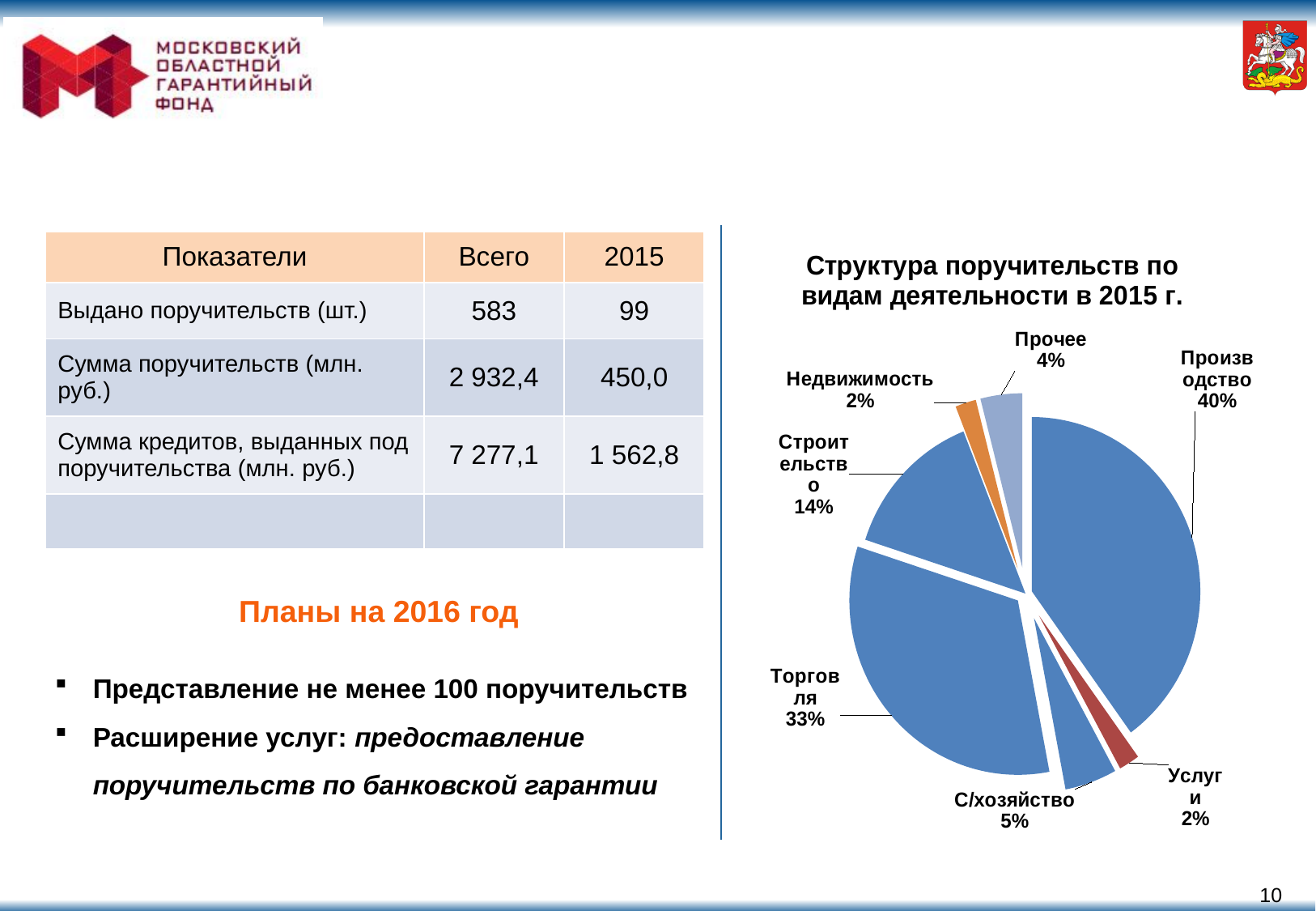
How many slices does the pie chart have? 7 What is the combined share of Производство and Торговля? 73% What share of the pie does С/хозяйство have? 5% What share of the pie does Строительство have? 14% Which category has the largest share of the pie? Производство What share of the pie does Прочее have? 4% What share of the pie does Производство have? 40% What kind of chart is shown on the slide? pie chart Which is larger, the share for Торговля or the share for Строительство? Торговля What share of the pie does Торговля have? 33% What is the title of the pie chart? Структура поручительств по видам деятельности в 2015 г. By how many percentage points does Производство exceed Торговля? 7